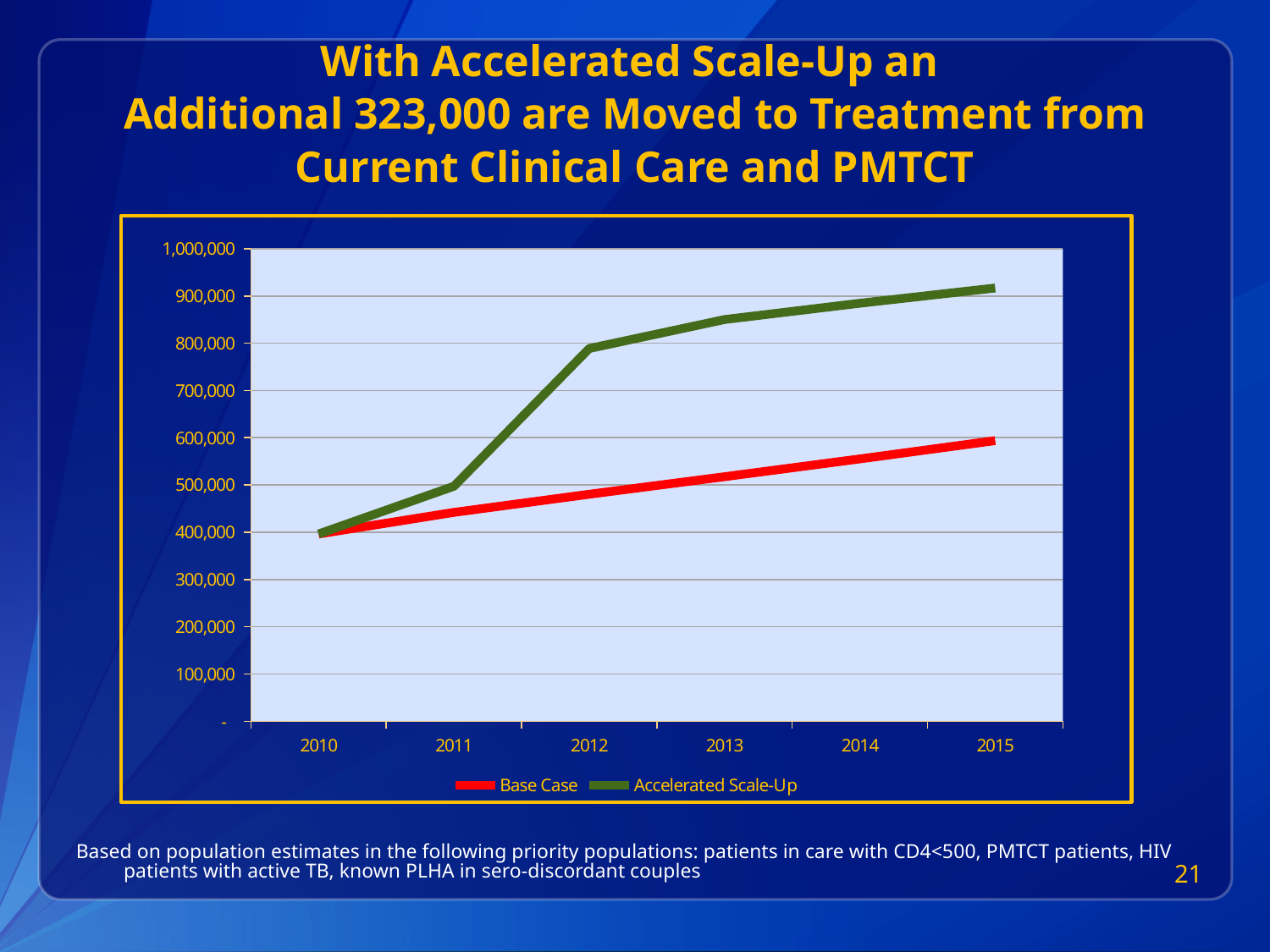
What kind of chart is shown on the slide? Line chart Which colour is used for the Base Case series? Red Does the Accelerated Scale-Up line rise or fall from 2010 to 2015? Rises How many years are shown on the x axis? 6 Is the Accelerated Scale-Up value for 2012 greater or less than 700,000? greater In which year is the Base Case value lowest? 2010 Does the Base Case line rise or fall from 2010 to 2015? Rises In which year is the Accelerated Scale-Up value highest? 2015 Is the Accelerated Scale-Up value for 2011 greater or less than 600,000? less In 2015, which series has the larger value, Base Case or Accelerated Scale-Up? Accelerated Scale-Up Is the Base Case value for 2015 greater or less than 500,000? greater How many series does the legend list? 2